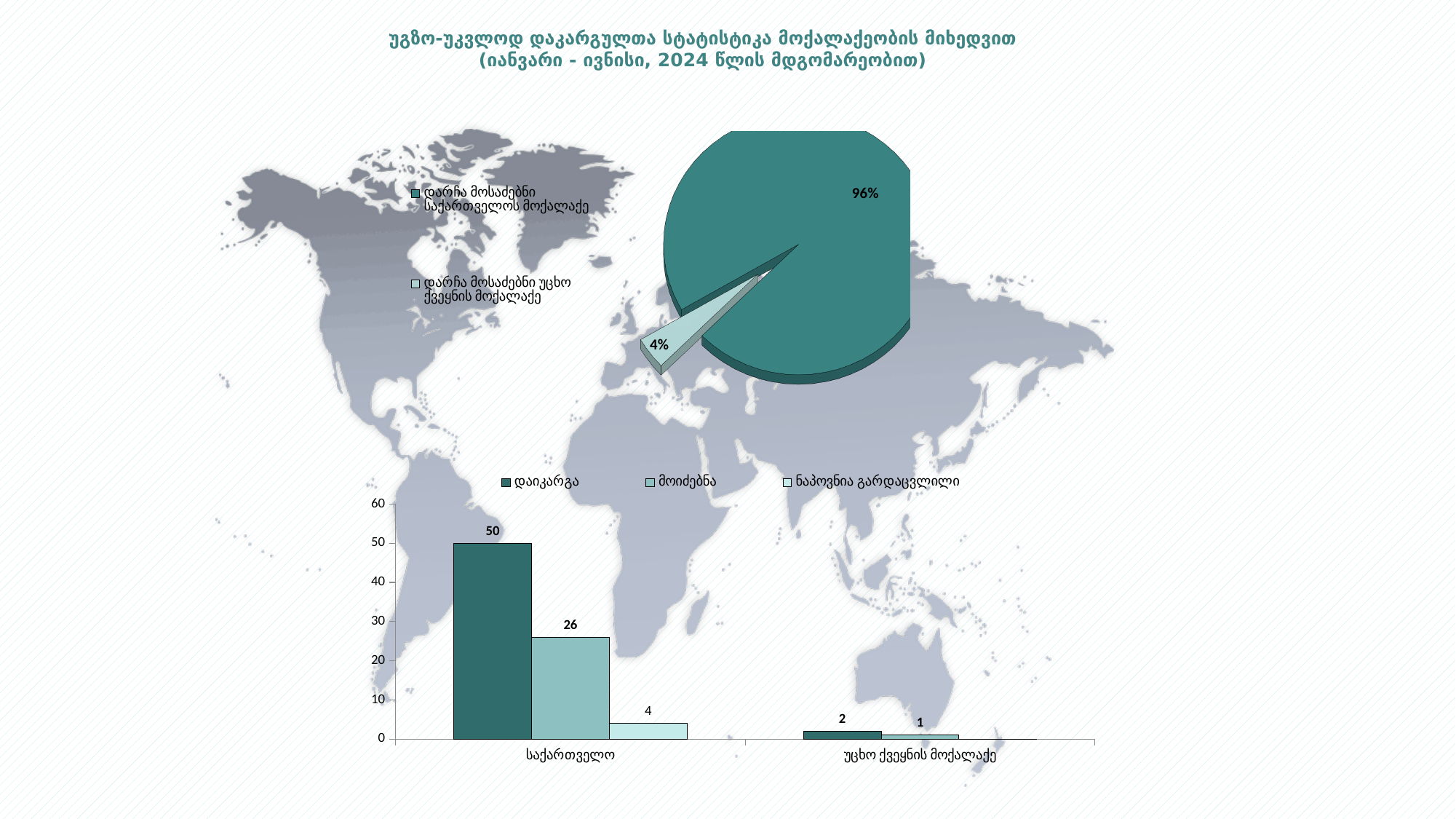
On the pie chart, what share is shown for დარჩა მოსაძებნი უცხო ქვეყნის მოქალაქე? 4% On the bar chart, what is the difference between დაიკარგა and მოიძებნა for საქართველო? 24 On the bar chart, what is the value of დაიკარგა for საქართველო? 50 On the pie chart, which slice is the largest? დარჩა მოსაძებნი საქართველოს მოქალაქე How many slices does the pie chart have? 2 On the bar chart, which is larger for უცხო ქვეყნის მოქალაქე: დაიკარგა or მოიძებნა? დაიკარგა On the bar chart, what is the value of დაიკარგა for უცხო ქვეყნის მოქალაქე? 2 On the pie chart, what share is shown for დარჩა მოსაძებნი საქართველოს მოქალაქე? 96% What type of chart is the lower chart on the slide? bar chart On the bar chart, what is the value of ნაპოვნია გარდაცვლილი for საქართველო? 4 How many series does the bar chart's legend list? 3 On the bar chart, what is the value of მოიძებნა for საქართველო? 26